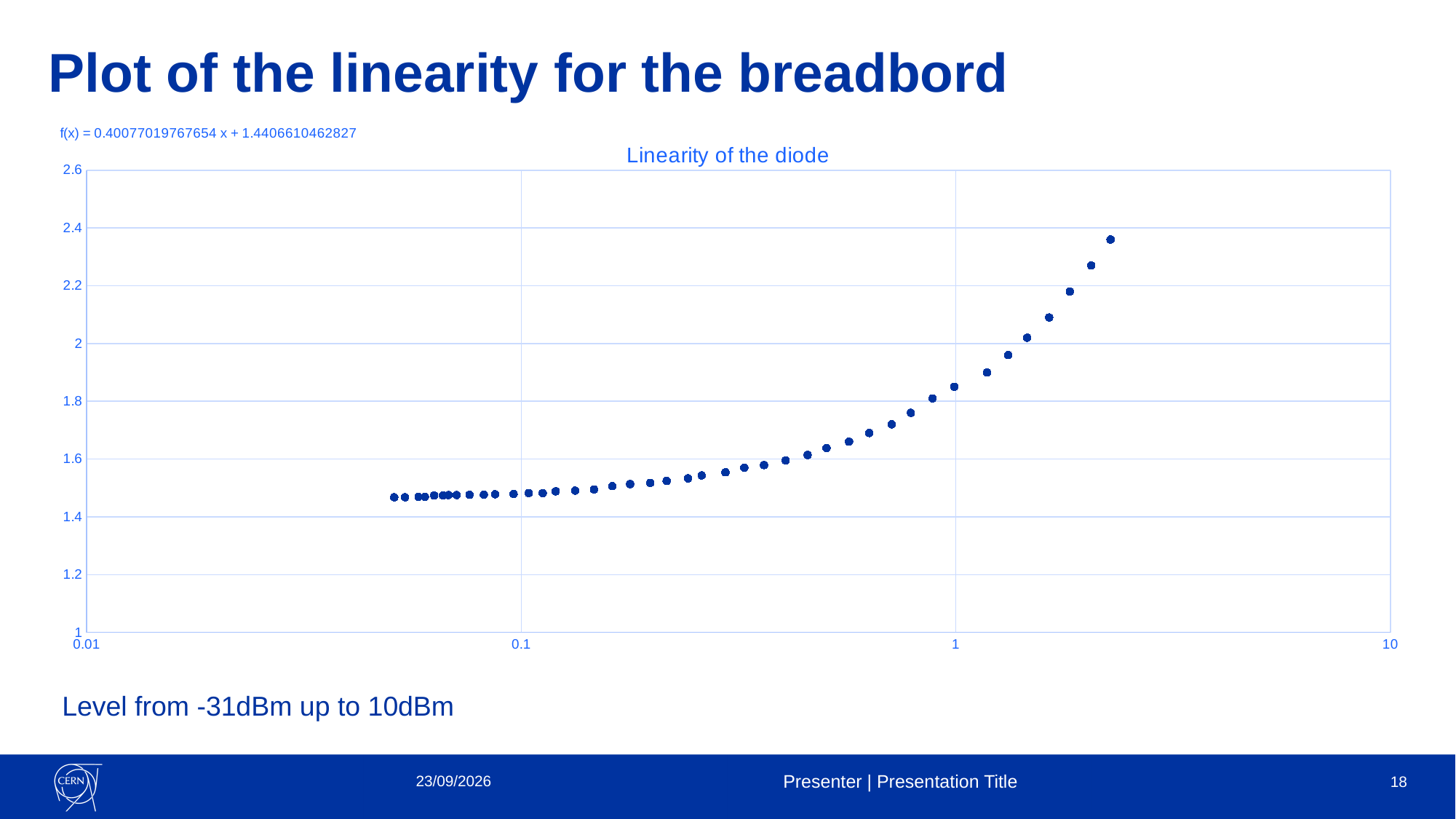
Which is larger, the value of the point at x = 1 or the value of the point at x = 0.1? the point at x = 1 Is the value of the plotted point at x = 1 greater or less than 2? less Is the value of the highest plotted point greater or less than 2.2? greater Do the plotted values rise or fall as the x-axis value increases? rise What is the maximum value shown on the y-axis? 2.6 What is the fitted line equation printed above the chart? f(x) = 0.40077019767654 x + 1.4406610462827 What is the title of the chart? Linearity of the diode Is the value of the rightmost plotted point greater or less than 2.4? less What kind of chart is shown on the slide? scatter plot